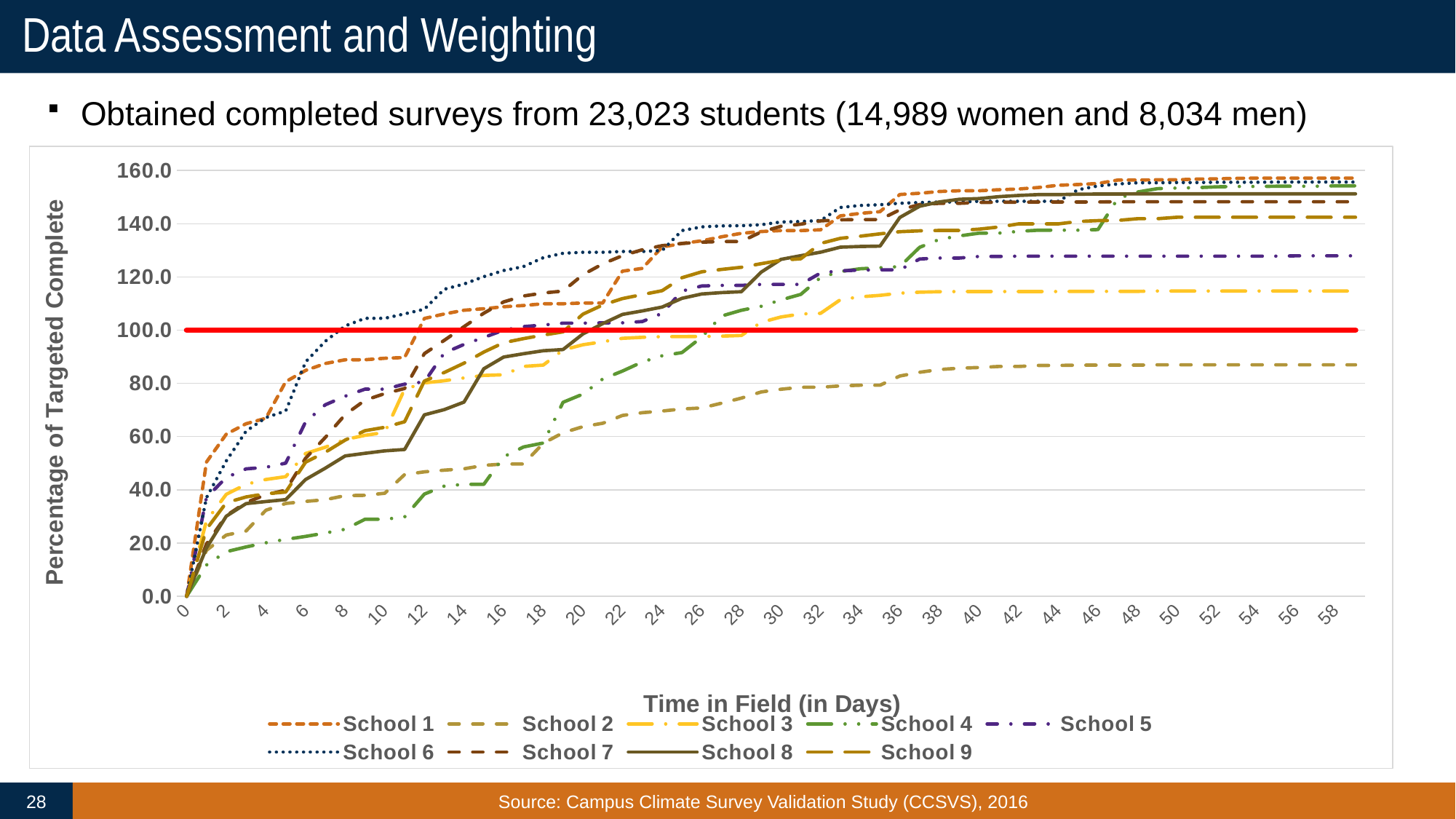
Is the value for School 3 at day 58 greater or less than 120? less Is the value for School 2 at day 20 greater or less than 80? less What is the label of the y axis? Percentage of Targeted Complete Do the values for the schools rise or fall as time in field increases? rise At what y-axis value is the solid red horizontal line drawn? 100.0 What type of chart is shown on the slide? line chart Is the value for School 1 at day 58 greater or less than 140? greater At day 58, which is larger: School 5 or School 9? School 9 Which school has the lowest value at day 58? School 2 How many series (schools) does the legend list? 9 What is the label of the x axis? Time in Field (in Days)